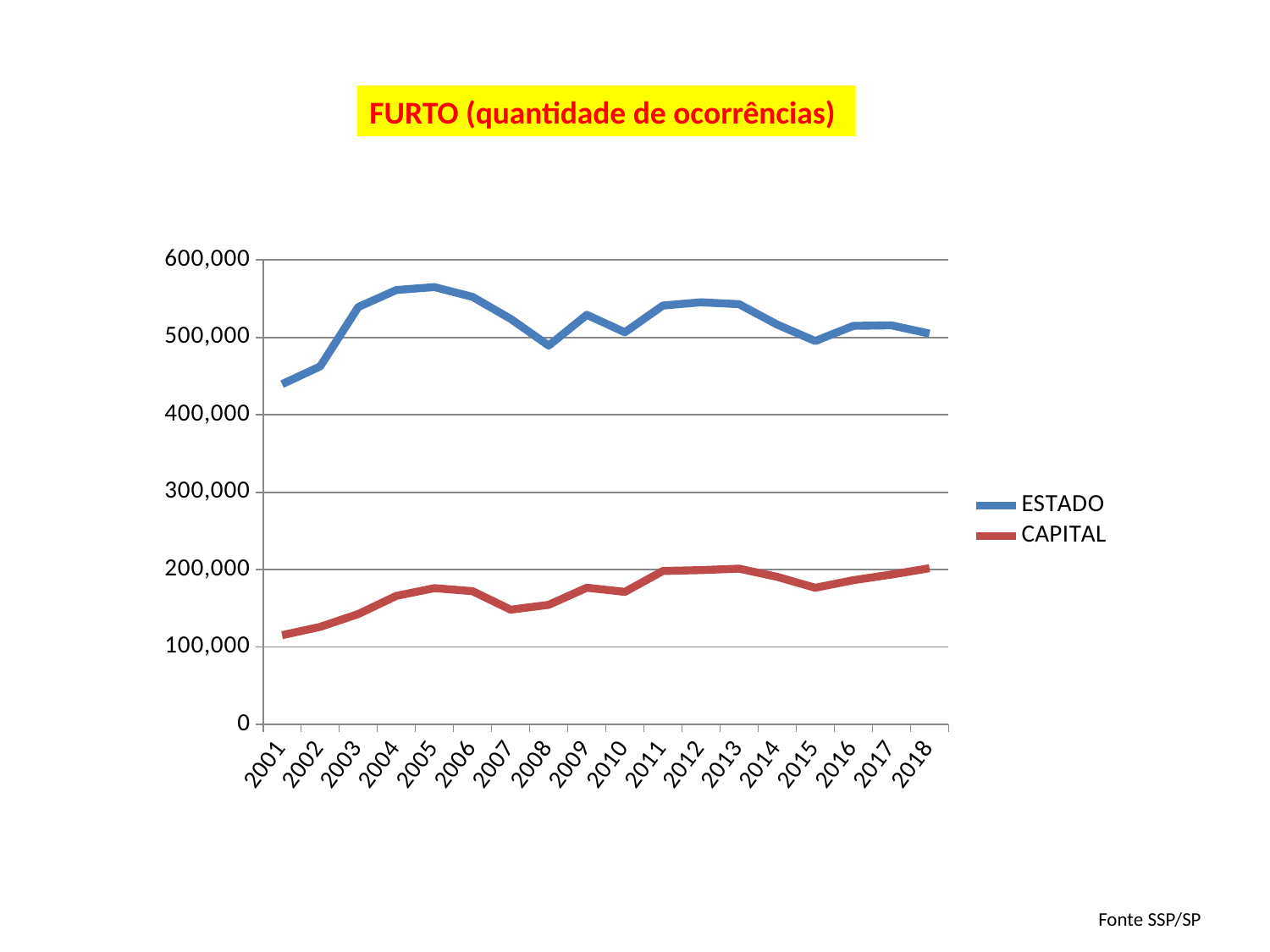
In which year is the CAPITAL series at its lowest? 2001 What is the title of the chart? FURTO (quantidade de ocorrências) Is the ESTADO value for 2005 greater or less than 500,000? greater What kind of chart is shown on the slide? line chart Is the ESTADO value for 2001 greater or less than 500,000? less Which series has the lower values throughout the chart, ESTADO or CAPITAL? CAPITAL How many series does the legend list? 2 Does the ESTADO series rise or fall from 2005 to 2008? fall How many years are plotted along the x axis? 18 Is the CAPITAL value for 2007 greater or less than 200,000? less In which year is the ESTADO series at its lowest? 2001 Does the ESTADO series rise or fall from 2001 to 2005? rise